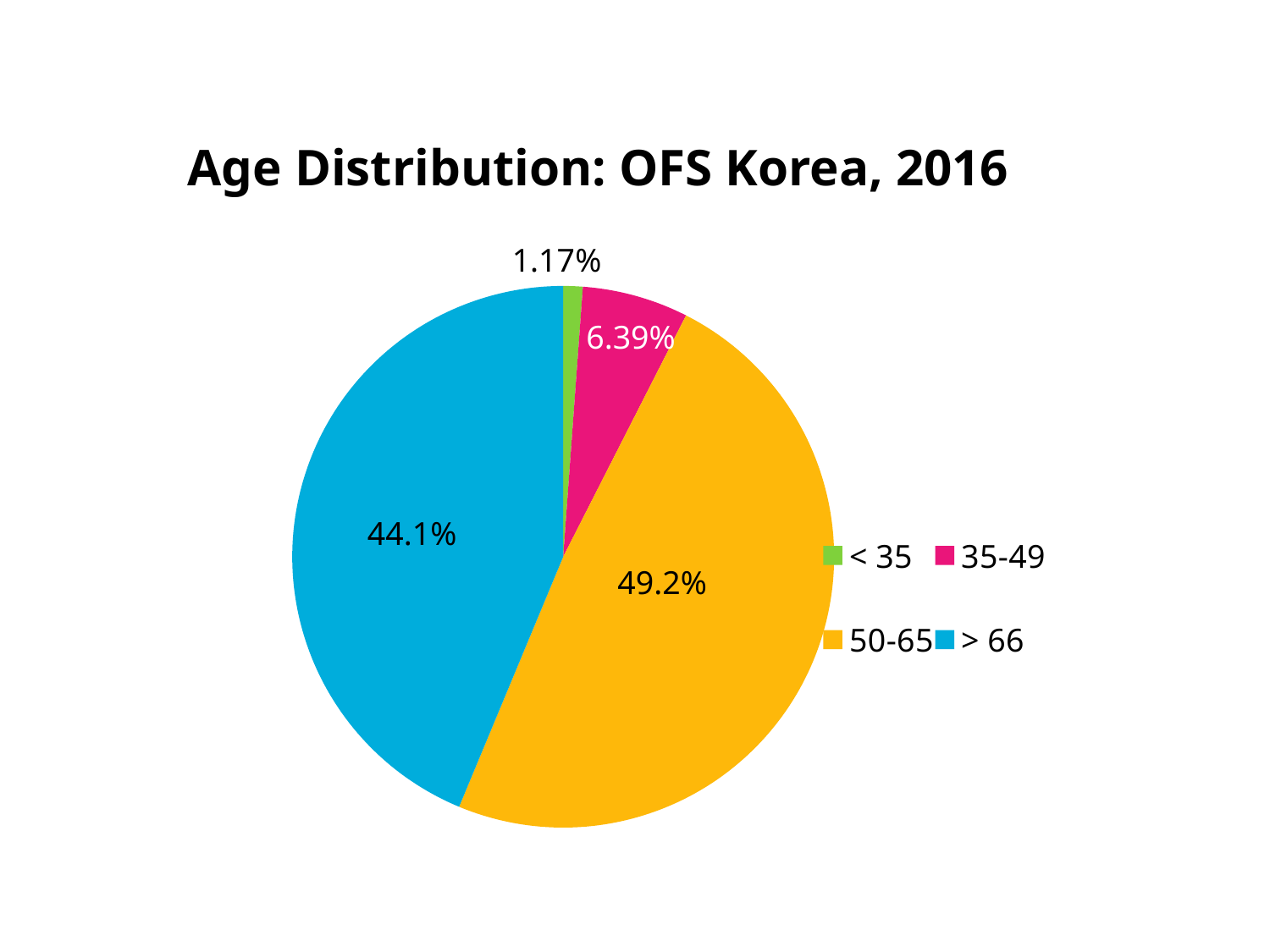
What colour is the slice for the > 66 age group? blue What is the difference between the shares for 50-65 and > 66? 5.1% What is the chart's title? Age Distribution: OFS Korea, 2016 What is the value shown for the < 35 age group? 1.17% What share of the pie does the 50-65 age group have? 49.2% Which is larger, the share for 50-65 or the share for > 66? 50-65 What kind of chart is shown on the slide? pie chart Which age group has the smallest share of the pie? < 35 How many age groups does the legend list? 4 What share of the pie does the > 66 age group have? 44.1% What is the value shown for the 35-49 age group? 6.39% Which age group has the largest share of the pie? 50-65